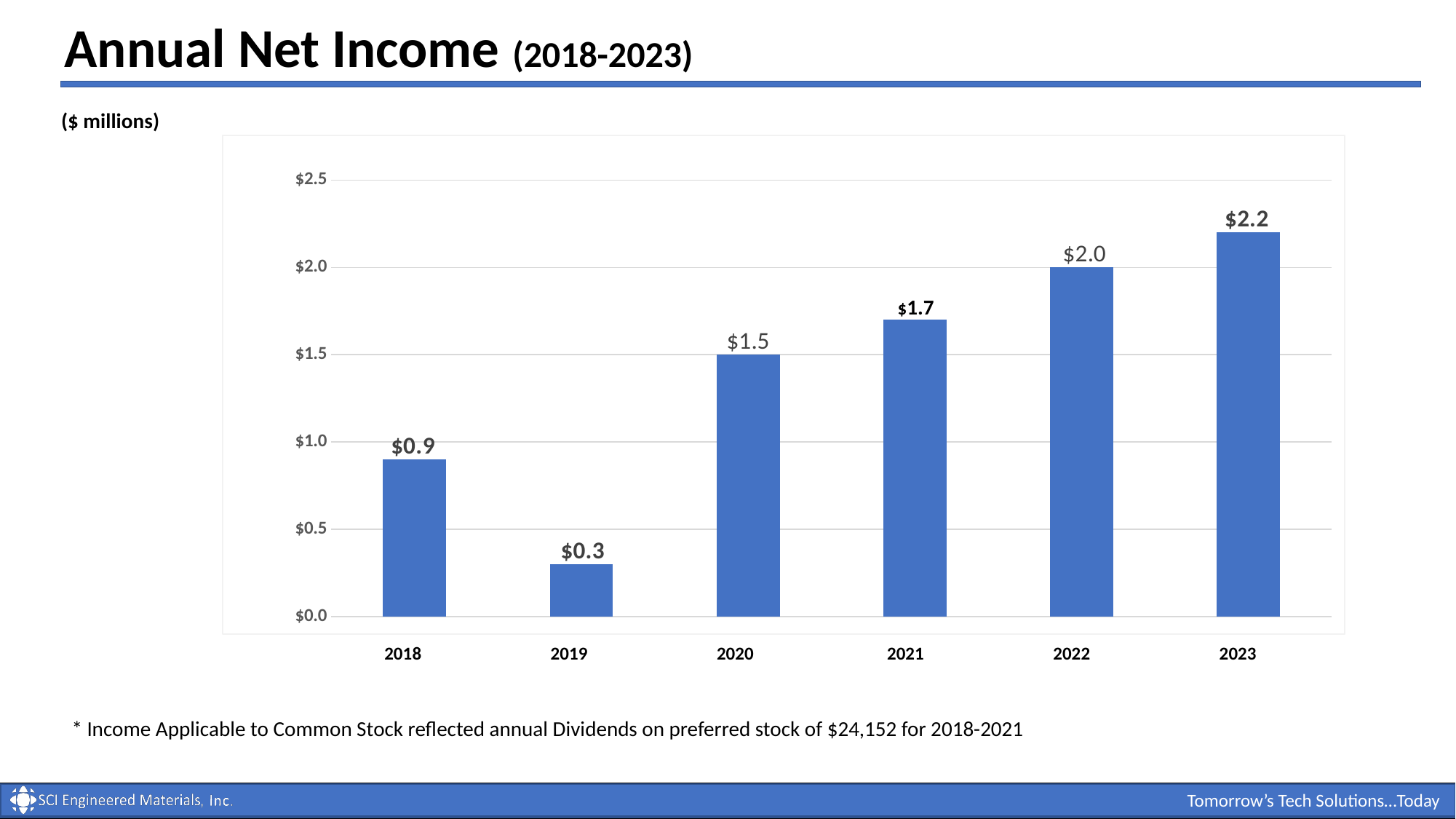
Is the value for 2021 greater or less than $1.5? greater Which year has the lowest annual net income? 2019 Which year has the larger net income, 2018 or 2020? 2020 How many years are shown on the chart? 6 Which year has the highest annual net income? 2023 What is the annual net income for 2020? $1.5 What is the annual net income for 2019? $0.3 What is the annual net income for 2023? $2.2 What kind of chart is shown on the slide? bar chart What is the difference between the net income in 2023 and in 2018? $1.3 Do the values rise or fall from 2019 to 2023? rise What is the difference between the net income in 2022 and in 2021? $0.3